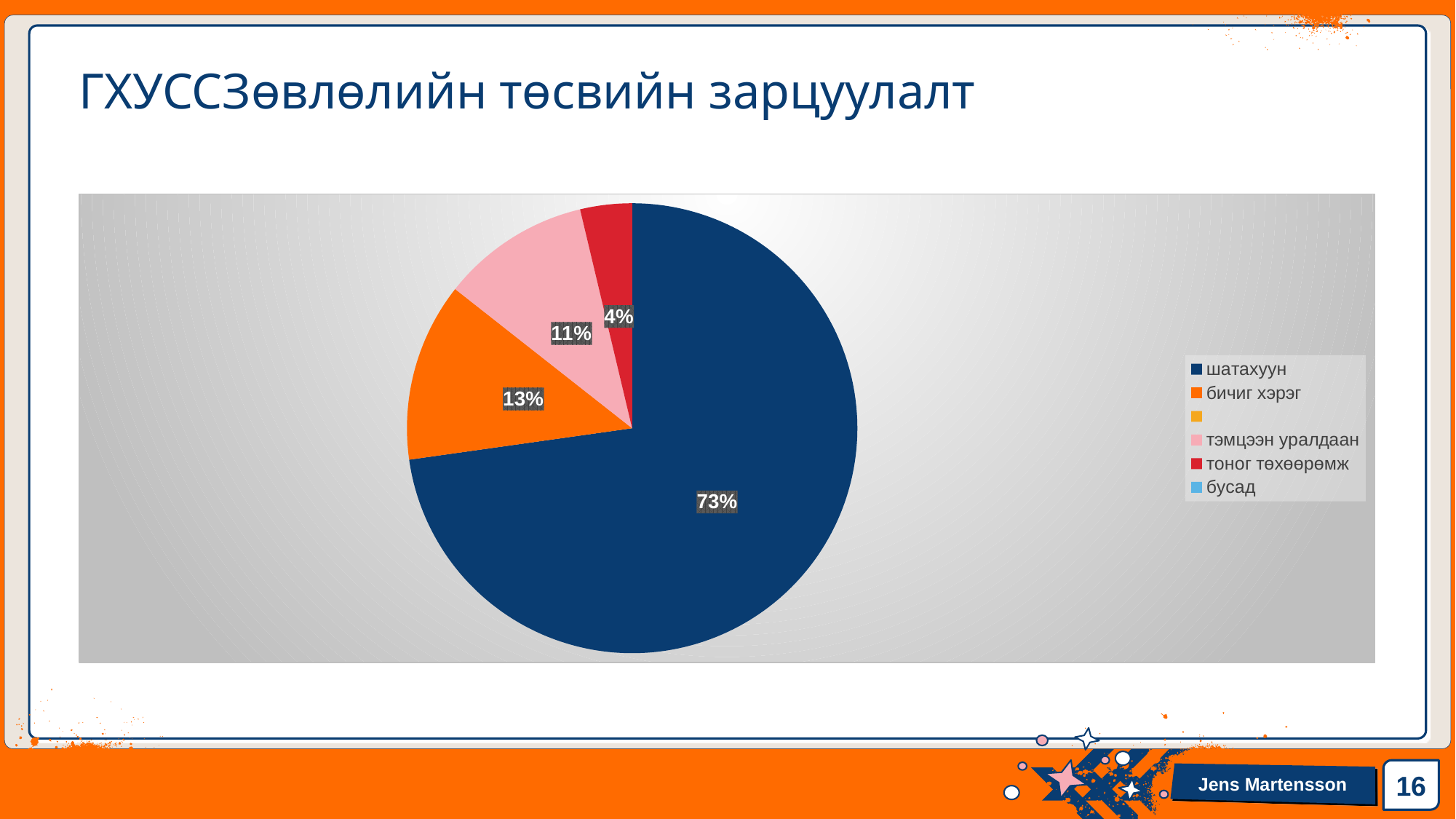
What is the difference in percentage points between the шатахуун slice and the бичиг хэрэг slice? 60 What share of the pie does тэмцээн уралдаан take? 11% What share of the pie does тоног төхөөрөмж take? 4% Which labelled slice of the pie is the smallest? тоног төхөөрөмж How many entries does the legend list? 6 What share of the pie does бичиг хэрэг take? 13% How many slices with data labels are visible in the pie? 4 Which category has the largest slice of the pie? шатахуун What kind of chart is shown on the slide? pie chart Which is larger, the slice for бичиг хэрэг or the slice for тэмцээн уралдаан? бичиг хэрэг What colour is the шатахуун slice? dark blue